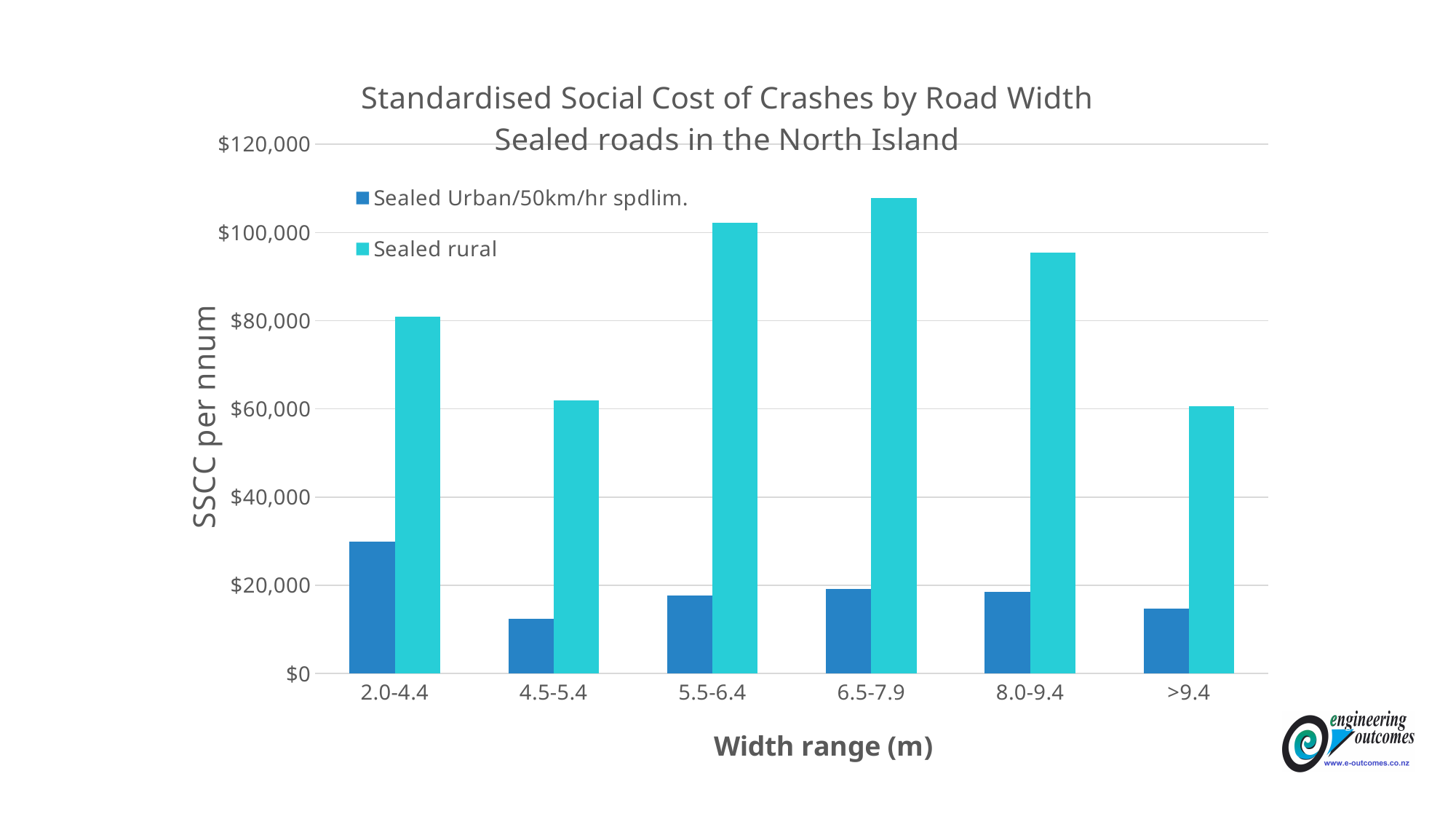
Is the Sealed rural value for 8.0-9.4 greater or less than $80,000? greater Is the Sealed Urban/50km/hr spdlim. value for 2.0-4.4 greater or less than $20,000? greater Is the Sealed Urban/50km/hr spdlim. value for 4.5-5.4 greater or less than $20,000? less Which width range has the highest value for Sealed rural? 6.5-7.9 How many series does the legend list? 2 What kind of chart is shown on the slide? bar chart Which width range has the highest value for Sealed Urban/50km/hr spdlim.? 2.0-4.4 How many width range categories are shown on the x axis? 6 What is the label on the x axis of the chart? Width range (m) For the 6.5-7.9 width range, which series has the larger value, Sealed Urban/50km/hr spdlim. or Sealed rural? Sealed rural